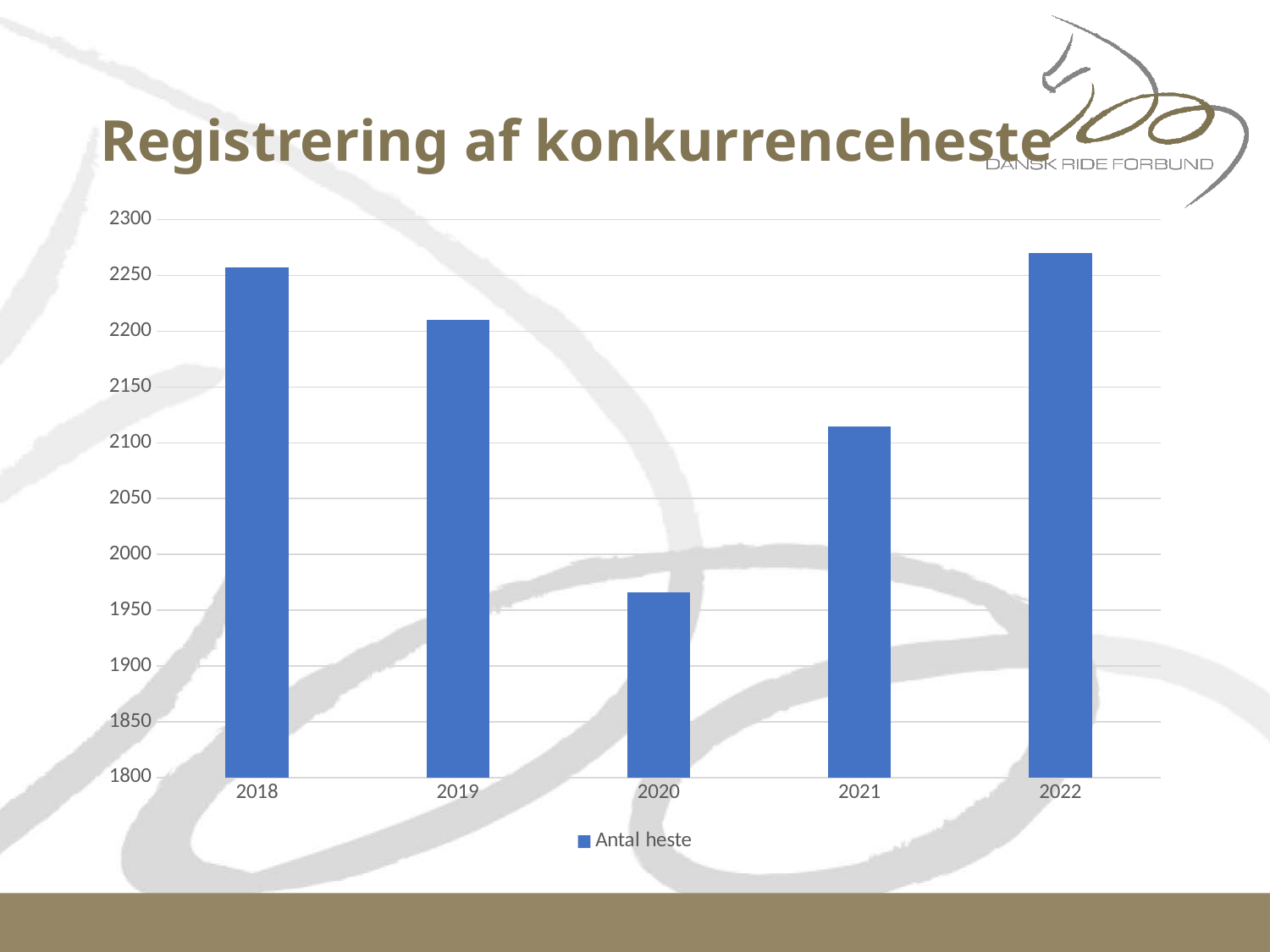
Which year has the highest bar in the chart? 2022 Which year has the lowest number of horses in the chart? 2020 How many series does the chart legend list? 1 What kind of chart is shown on the slide? bar chart Which year has the larger value, 2019 or 2021? 2019 Is the value for 2022 greater or less than 2250? greater What is the series name shown in the chart legend? Antal heste How many years are shown on the x axis of the chart? 5 Do the values rise or fall from 2020 to 2022? rise Is the value for 2021 greater or less than 2100? greater Is the value for 2020 greater or less than 2000? less